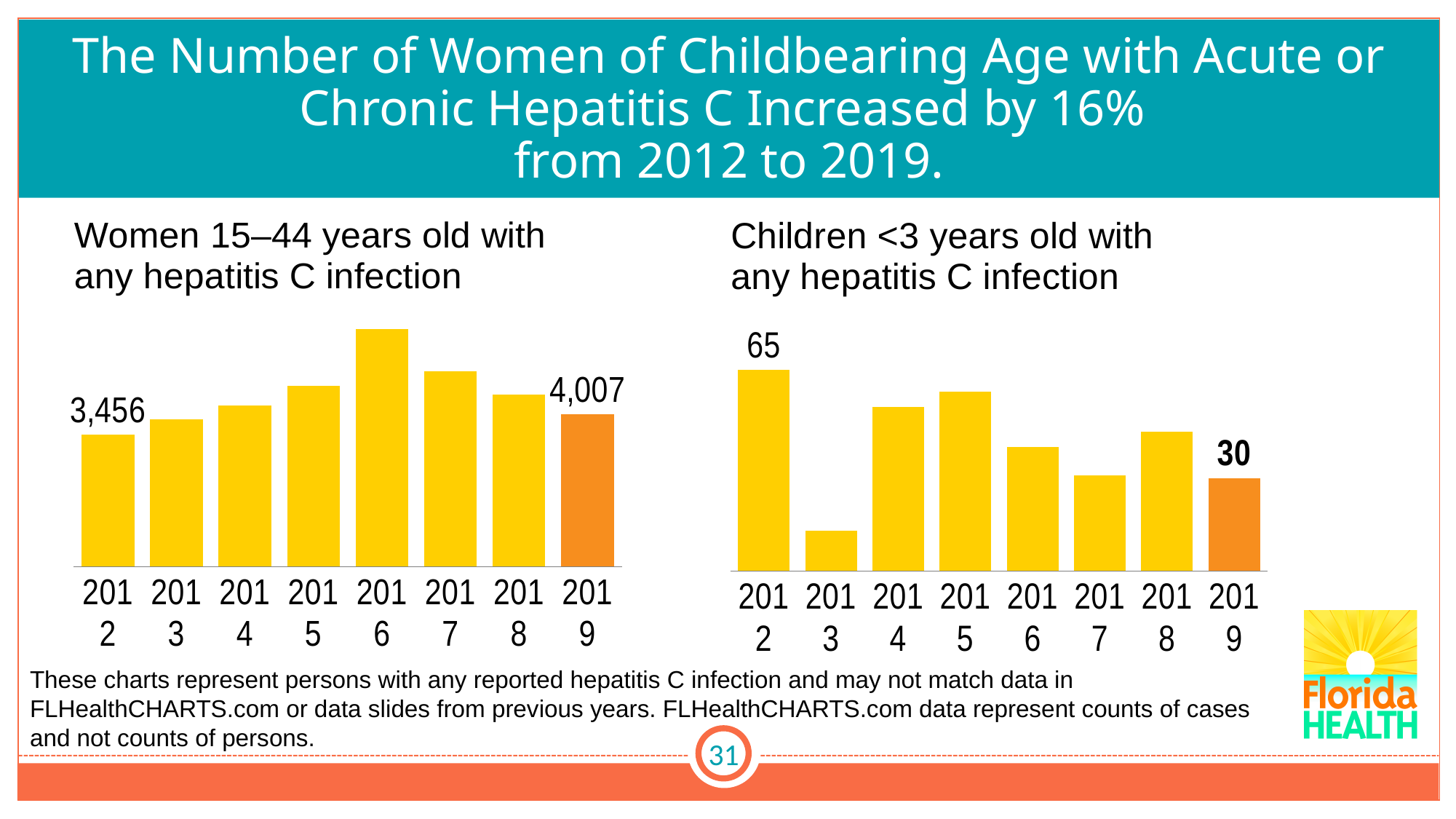
In the chart 'Children <3 years old with any hepatitis C infection', which is larger, the value for 2012 or the value for 2019? 2012 In the chart 'Women 15–44 years old with any hepatitis C infection', what is the value for 2012? 3,456 In the chart 'Children <3 years old with any hepatitis C infection', which year has the highest value? 2012 In the chart 'Children <3 years old with any hepatitis C infection', which year has the lowest value? 2013 What kind of chart is the 'Children <3 years old with any hepatitis C infection' chart? Bar chart In the chart 'Children <3 years old with any hepatitis C infection', what is the value for 2019? 30 In the chart 'Women 15–44 years old with any hepatitis C infection', what is the difference between the 2019 and 2012 values? 551 In the chart 'Children <3 years old with any hepatitis C infection', what is the value for 2012? 65 In the chart 'Women 15–44 years old with any hepatitis C infection', what is the value for 2019? 4,007 How many years are shown in the chart 'Women 15–44 years old with any hepatitis C infection'? 8 In the chart 'Children <3 years old with any hepatitis C infection', what is the difference between the 2012 and 2019 values? 35 In the chart 'Women 15–44 years old with any hepatitis C infection', which year has the highest value? 2016